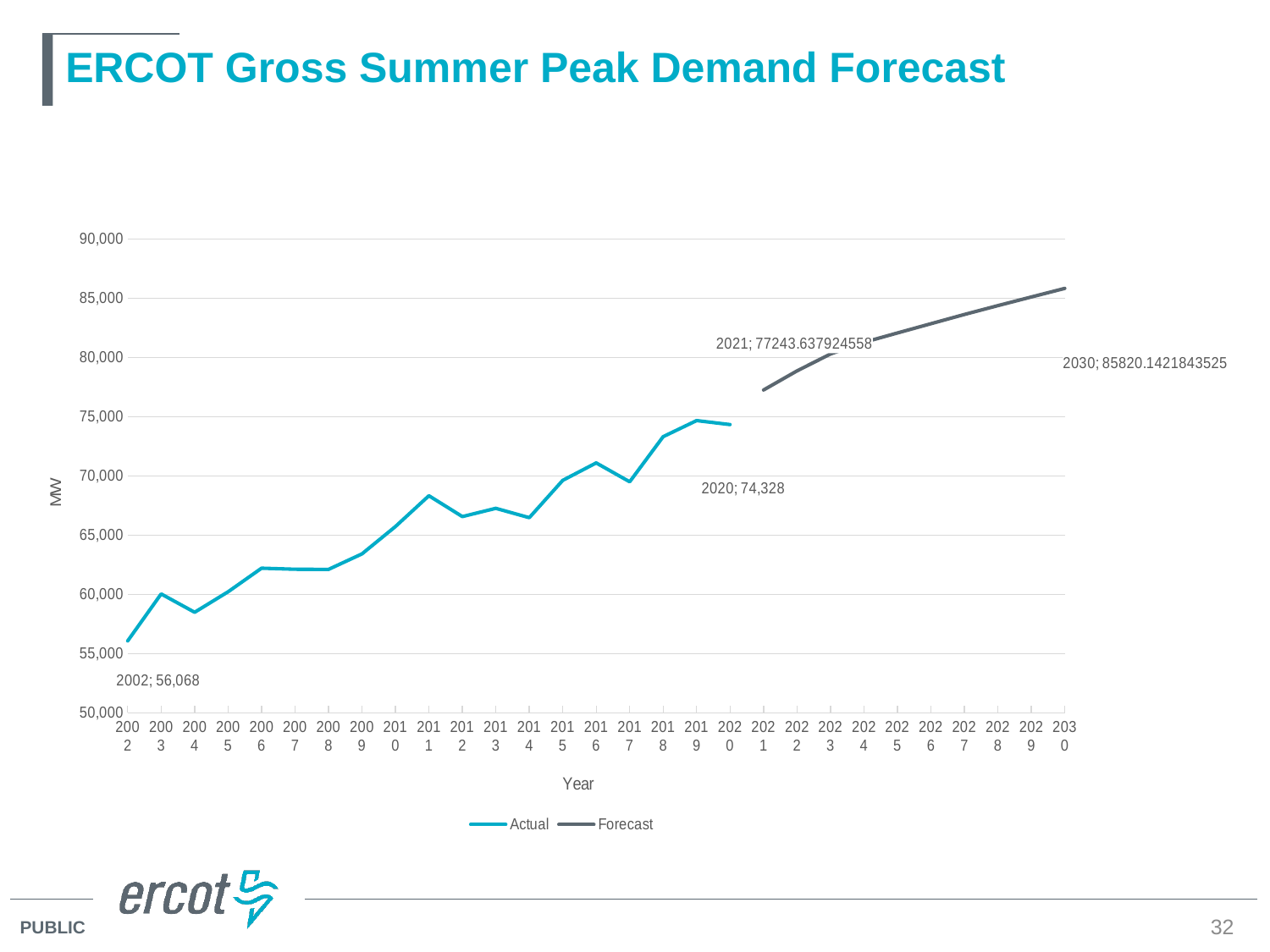
What is the label on the vertical axis? MW Is the Actual value for 2004 greater or less than 60,000? less What is the Actual value labelled for 2020? 74,328 By how much does the labelled Actual value for 2020 exceed the labelled Actual value for 2002? 18,260 Which year has the higher Actual value, 2017 or 2018? 2018 Which year has the lowest Actual value? 2002 Is the Actual value for 2011 greater or less than 65,000? greater What is the Forecast value labelled for 2021? 77243.637924558 How many series does the legend list? 2 What is the Forecast value labelled for 2030? 85820.1421843525 What kind of chart is shown on the slide? Line chart What is the Actual value labelled for 2002? 56,068